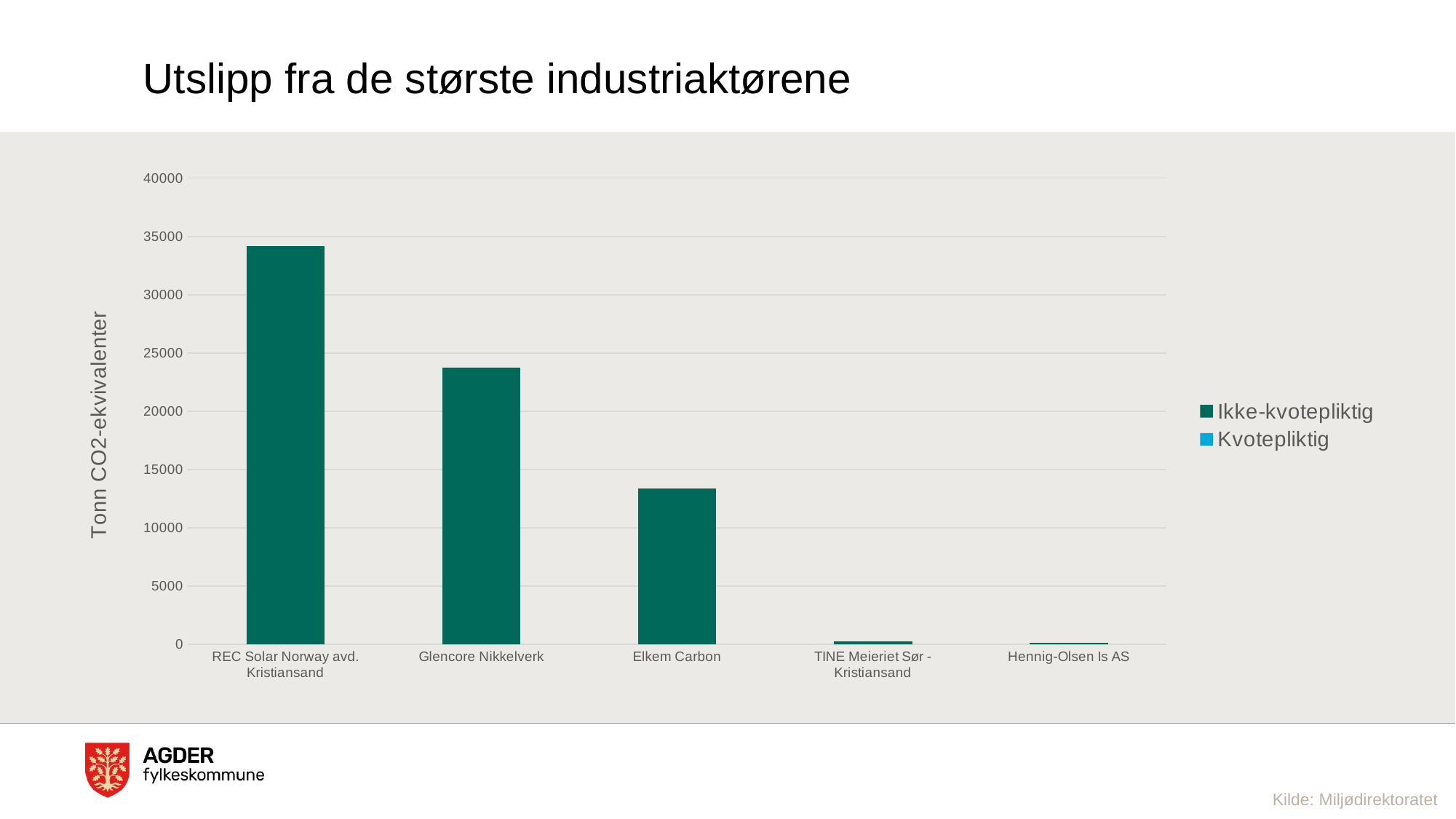
How many companies are shown on the x axis of the chart? 5 How many series does the legend list? 2 What is the label on the y axis of the chart? Tonn CO2-ekvivalenter What kind of chart is shown on the slide? bar chart Which company has the highest emissions in the chart? REC Solar Norway avd. Kristiansand Do the bar values rise or fall from left to right along the x axis? fall Is the value for TINE Meieriet Sør - Kristiansand greater or less than 5000? less Which has higher emissions, Glencore Nikkelverk or Elkem Carbon? Glencore Nikkelverk Is the value for Elkem Carbon greater or less than 10000? greater Is the value for REC Solar Norway avd. Kristiansand greater or less than 30000? greater What is the title of the chart on the slide? Utslipp fra de største industriaktørene